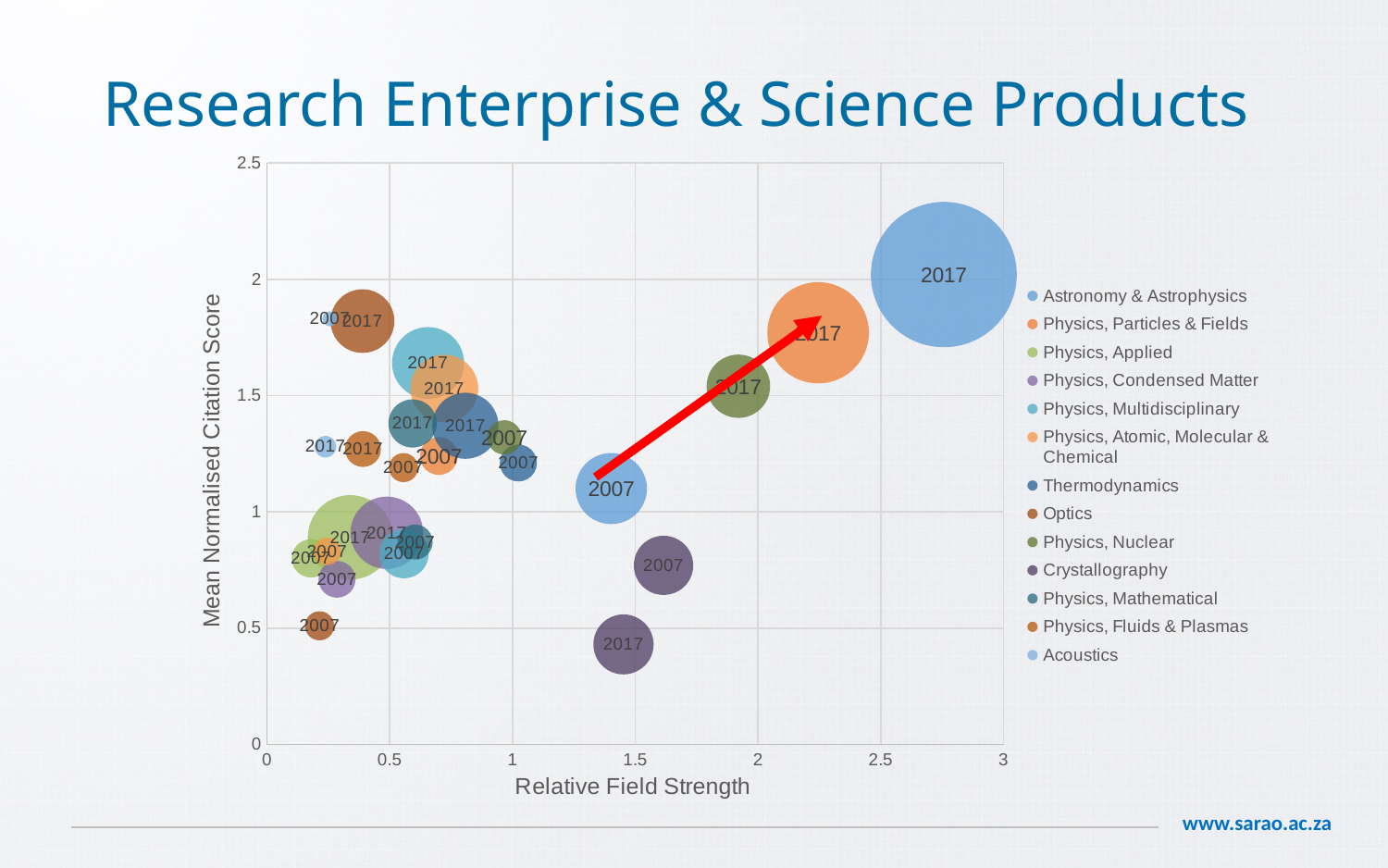
How many series does the legend list? 13 Is the Relative Field Strength of the Astronomy & Astrophysics 2007 bubble greater or less than 1.5? less What is the title of the chart's vertical axis? Mean Normalised Citation Score Which series has the bubble with the highest Relative Field Strength? Astronomy & Astrophysics Which has the higher Relative Field Strength: the Astronomy & Astrophysics 2017 bubble or the Physics, Particles & Fields 2017 bubble? Astronomy & Astrophysics 2017 Is the Relative Field Strength of the Astronomy & Astrophysics 2017 bubble greater or less than 2.5? greater Is the Mean Normalised Citation Score of the Crystallography 2017 bubble greater or less than 0.5? less What is the title of the chart's horizontal axis? Relative Field Strength What kind of chart is shown on the slide? Bubble chart Which series has the largest bubble on the chart? Astronomy & Astrophysics Between 2007 and 2017, did the Mean Normalised Citation Score for Astronomy & Astrophysics rise or fall? rise